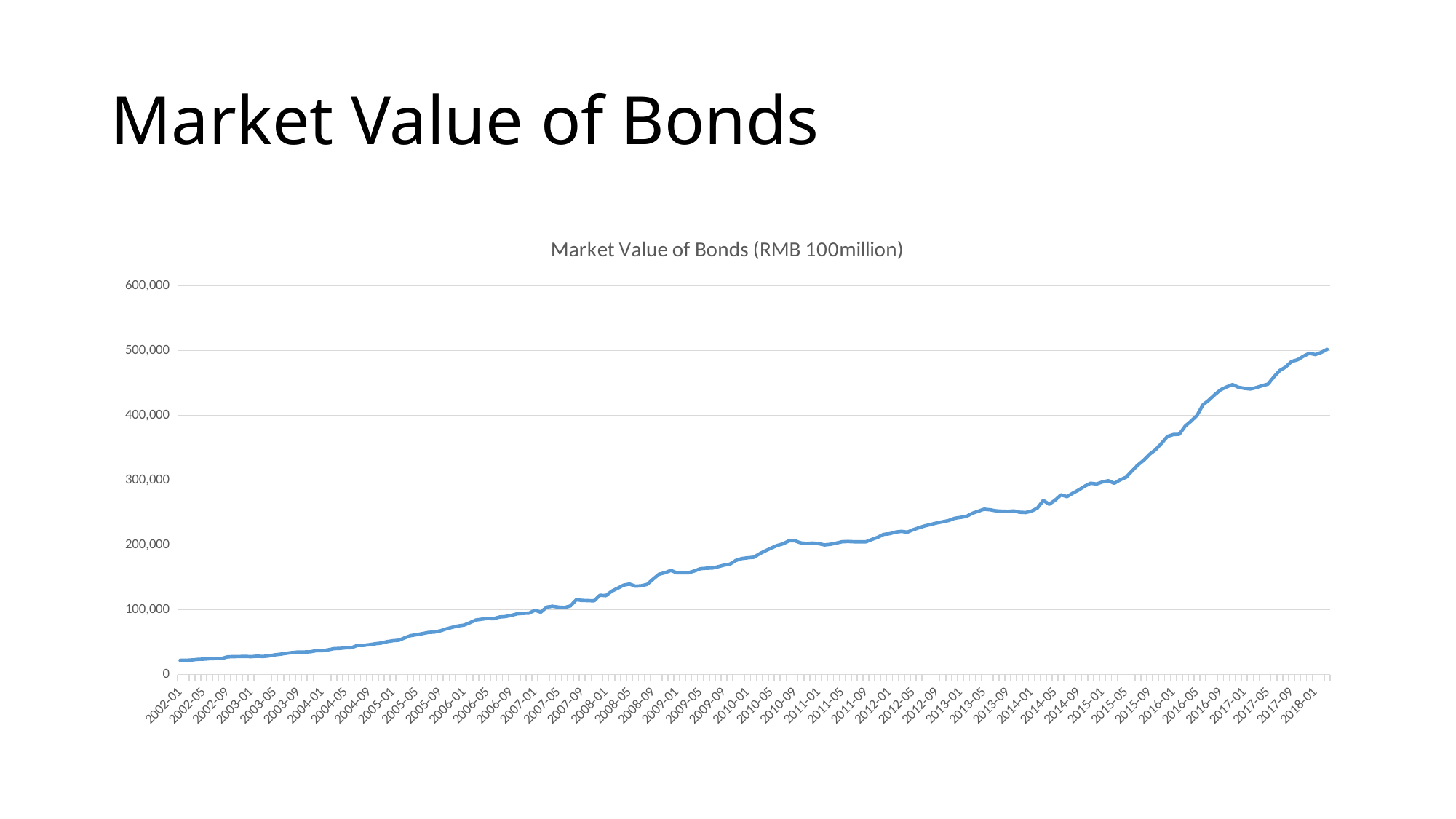
Which x-axis label has the highest market value of bonds? 2018-01 What is the title of the chart? Market Value of Bonds (RMB 100million) What is the highest value shown on the vertical axis? 600,000 Is the value for 2016-01 greater or less than 300,000? greater Is the value for 2017-01 greater or less than 500,000? less Do the values generally rise or fall from 2002-01 to 2018-01? rise Is the value for 2013-05 greater or less than 200,000? greater What kind of chart is shown on the slide? line chart Which x-axis label has the lowest market value of bonds? 2002-01 Which is larger, the value for 2010-01 or the value for 2015-01? 2015-01